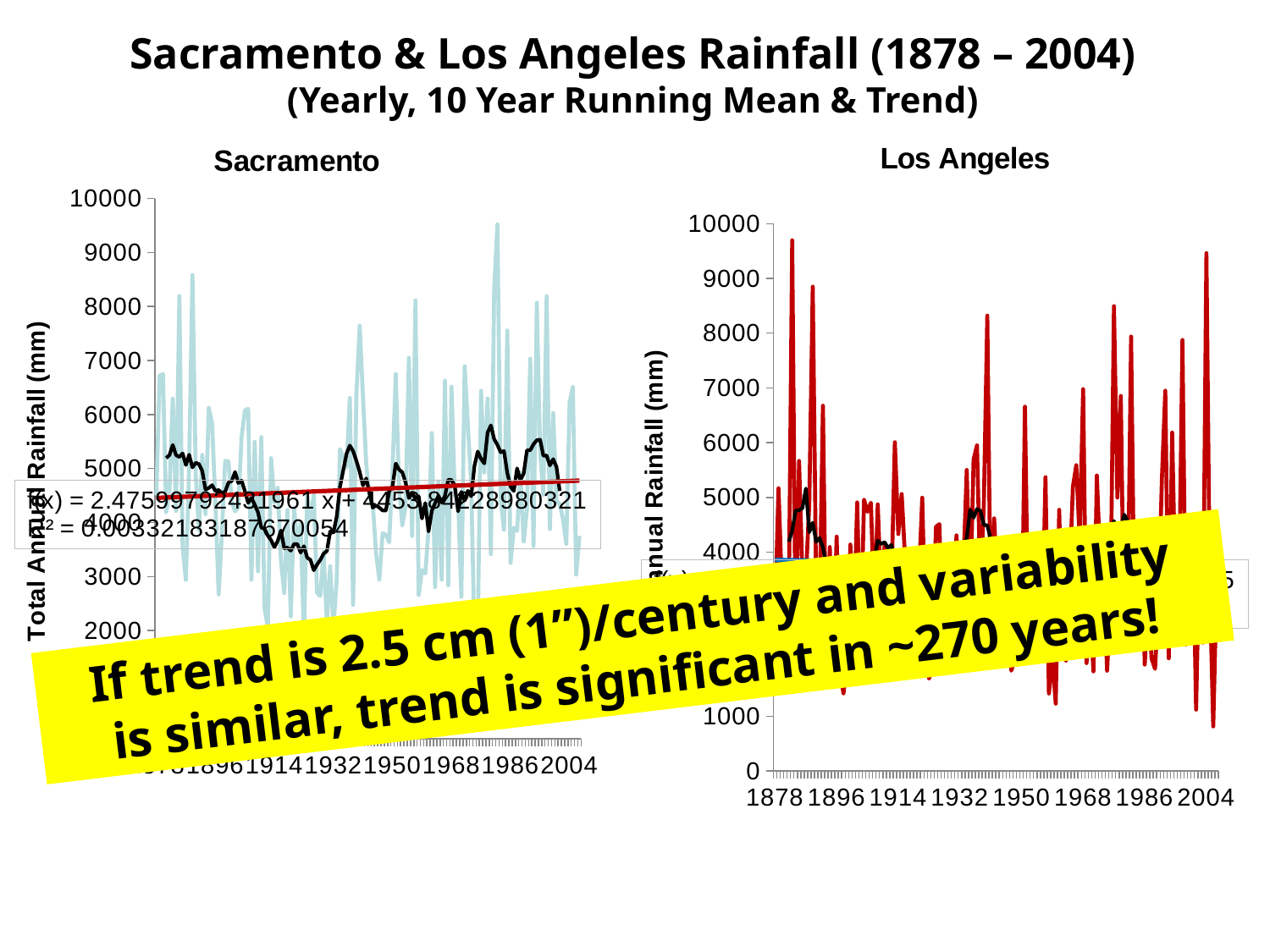
On the Los Angeles chart, what is the first year shown on the x axis? 1878 On the Sacramento chart, is the lowest point of the 10-year running mean (black line) greater or less than 4000? less On the Sacramento chart, what is the lowest value shown on the y axis? 2000 What is the y-axis label on the Sacramento chart? Total Annual Rainfall (mm) On the Sacramento chart, is the highest yearly rainfall value greater or less than 9000? greater On the Los Angeles chart, is the highest yearly rainfall value greater or less than 9000? greater What kind of chart is the Sacramento chart? line chart On the Los Angeles chart, what is the last year shown on the x axis? 2004 What is the title of the chart on the right? Los Angeles How many charts are shown on the slide? 2 On the Los Angeles chart, what is the highest value shown on the y axis? 10000